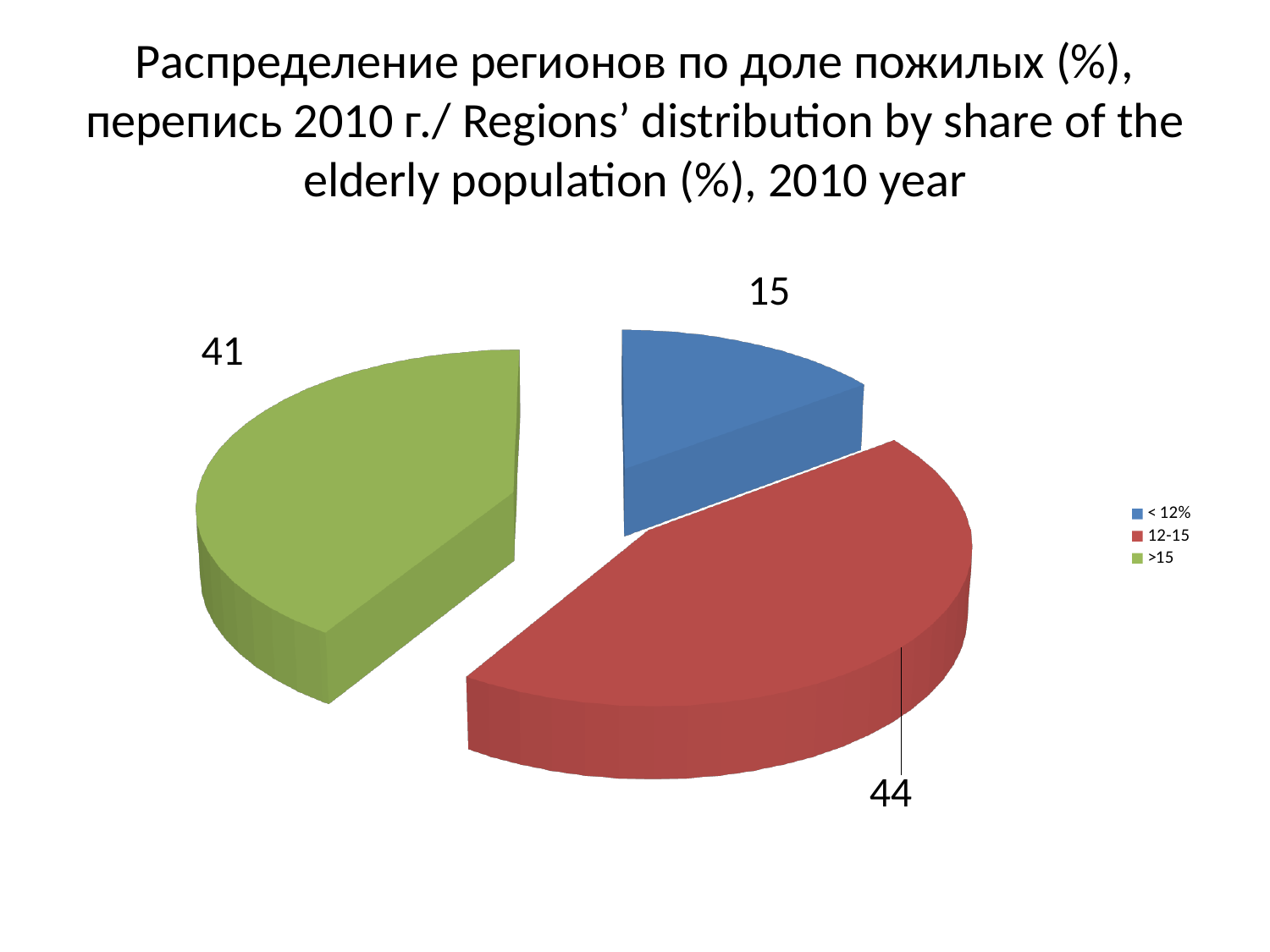
What is the value for the "< 12%" category? 15 What is the difference between the values for "12-15" and "< 12%"? 29 What type of chart is shown on the slide? pie chart What colour is the slice for the "12-15" category? red Which category has the smallest slice of the pie? < 12% How many categories does the pie chart have? 3 What is the difference between the values for "12-15" and ">15"? 3 Which is larger, the value for ">15" or the value for "< 12%"? >15 What is the value for the "12-15" category? 44 What share of the pie does the ">15" slice represent? 41% Which category has the largest slice of the pie? 12-15 What is the value for the ">15" category? 41